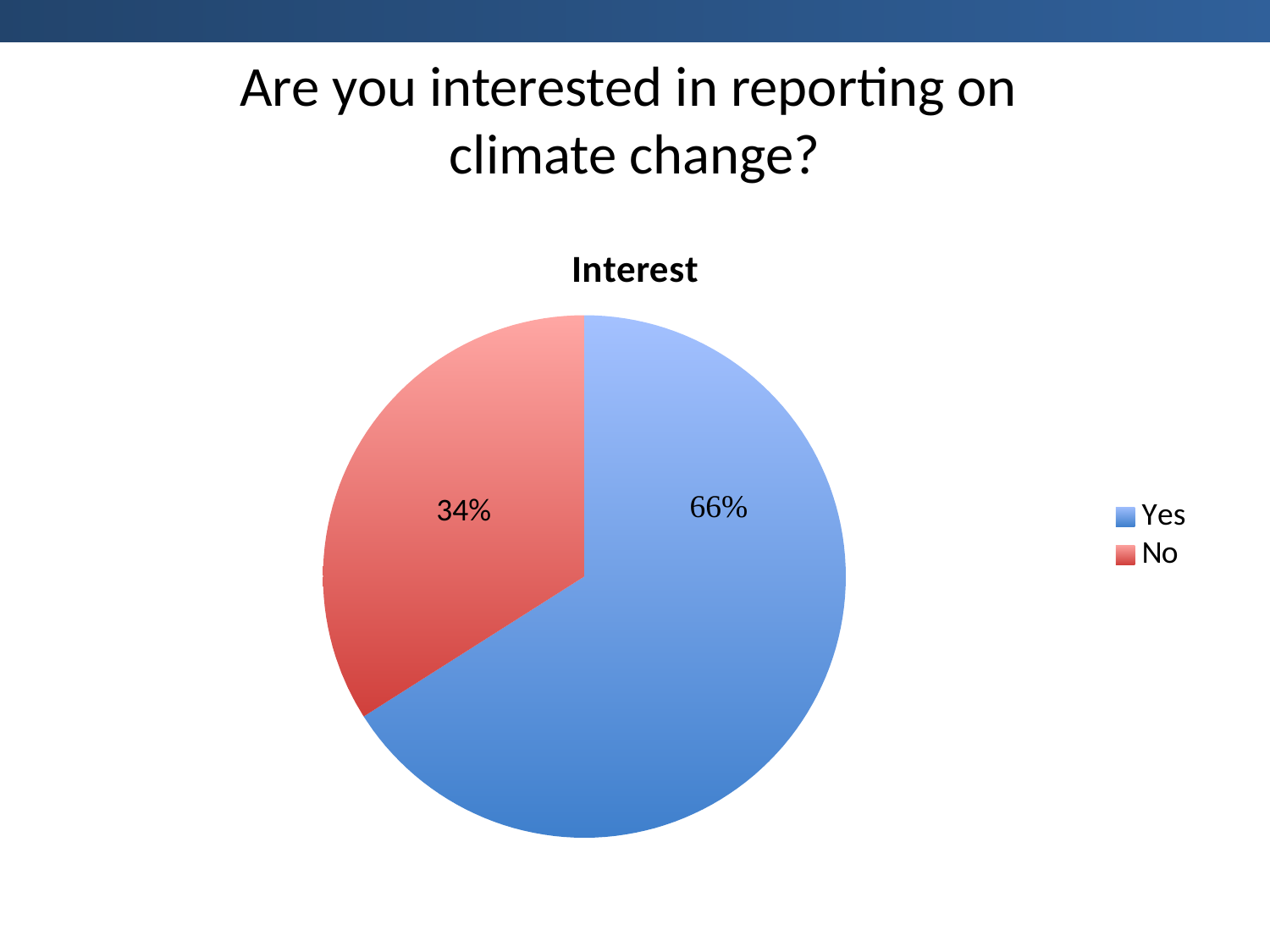
Which response has the smallest share of the pie? No How many categories does the pie chart show? 2 What is the title of the chart? Interest What share of the pie does the No slice represent? 34% Which is larger, the Yes slice or the No slice? Yes What type of chart is shown on the slide? pie chart What percentage of respondents answered No? 34% What percentage of respondents answered Yes? 66% Which response has the largest share of the pie? Yes What is the difference in percentage points between the Yes and No slices? 32 What colour is the Yes slice? blue How many entries does the legend list? 2